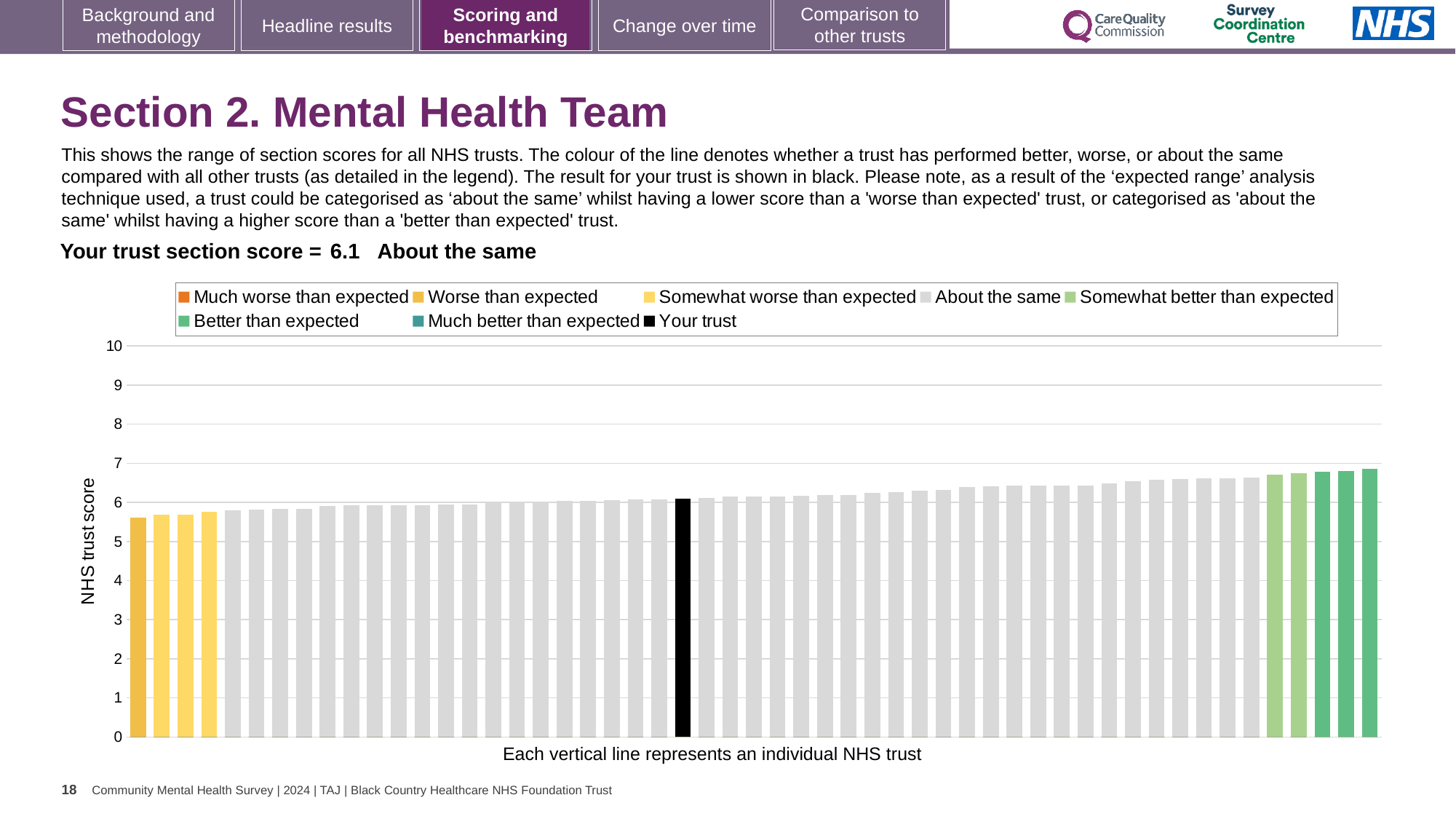
Which legend category does the highest bar belong to? Better than expected What is the section score for your trust (the black bar)? 6.1 Is the value for the black 'Your trust' bar greater or less than 7? less How many bars are coloured as 'Better than expected'? 3 Is the value for the rightmost bar greater or less than 7? less How many entries does the chart legend list? 8 What is the label on the y axis of the chart? NHS trust score Which is higher, the rightmost bar or the black 'Your trust' bar? the rightmost bar Which legend category does the lowest bar belong to? Worse than expected What kind of chart is shown on the slide? bar chart Is the value for the leftmost bar greater or less than 5? greater Do the bar values rise or fall from left to right along the x axis? rise